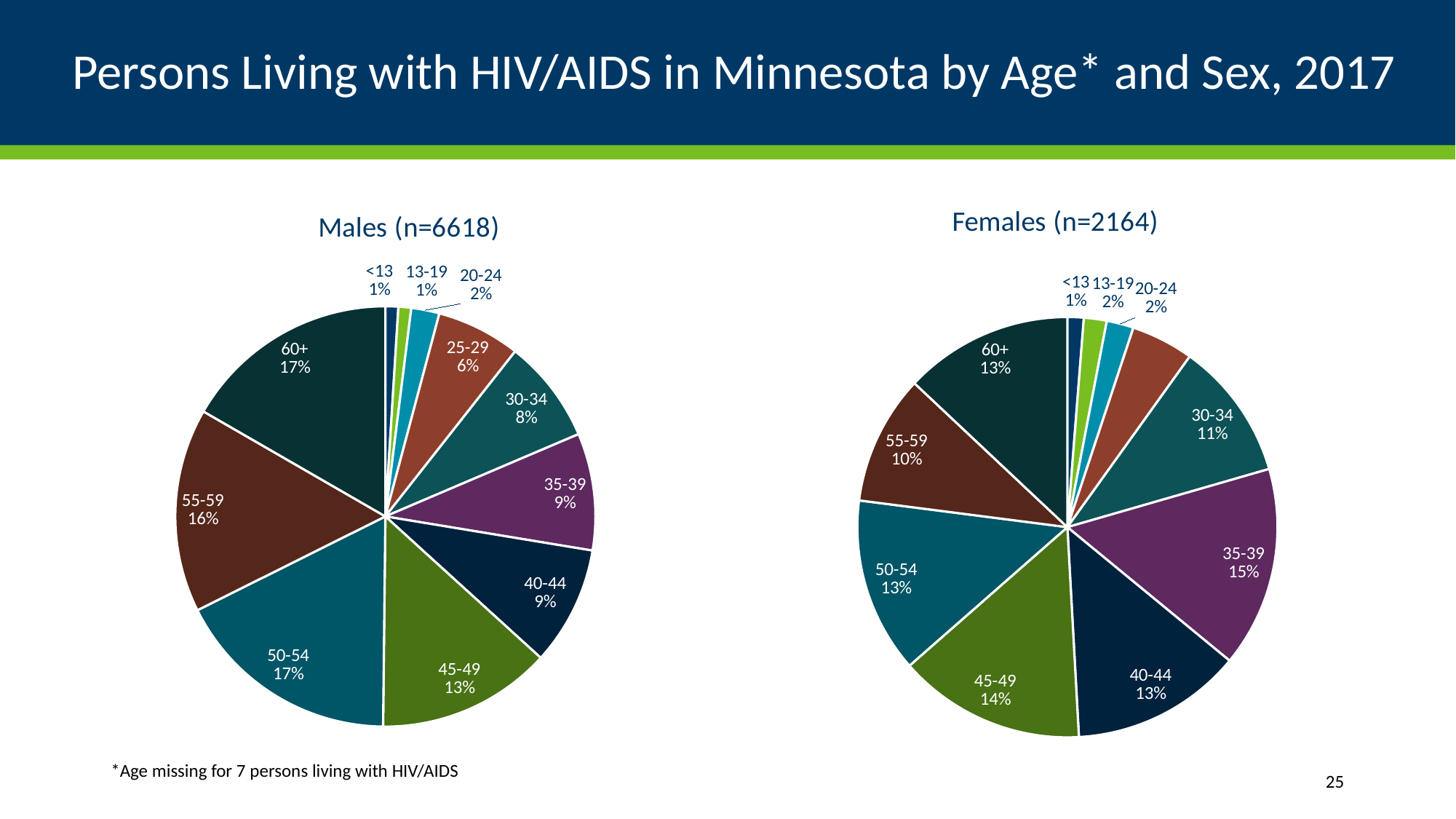
What type of chart is used for the Males (n=6618) data? Pie chart How many age categories are labelled in the Males (n=6618) pie chart? 11 In the Females (n=2164) pie chart, what percentage is the 55-59 age group? 10% In the Males (n=6618) pie chart, which is larger: the 55-59 share or the 30-34 share? 55-59 In the Males (n=6618) pie chart, what is the difference in percentage points between the 60+ and 45-49 age groups? 4 In the Females (n=2164) pie chart, which is larger: the 30-34 share or the 45-49 share? 45-49 In the Females (n=2164) pie chart, what percentage is the 35-39 age group? 15% What is the title of the chart on the right side of the slide? Females (n=2164) In the Males (n=6618) pie chart, what percentage is the 50-54 age group? 17% In the Males (n=6618) pie chart, what percentage is the 25-29 age group? 6% In the Females (n=2164) pie chart, which age group has the smallest share? <13 In the Females (n=2164) pie chart, which age group has the largest share? 35-39